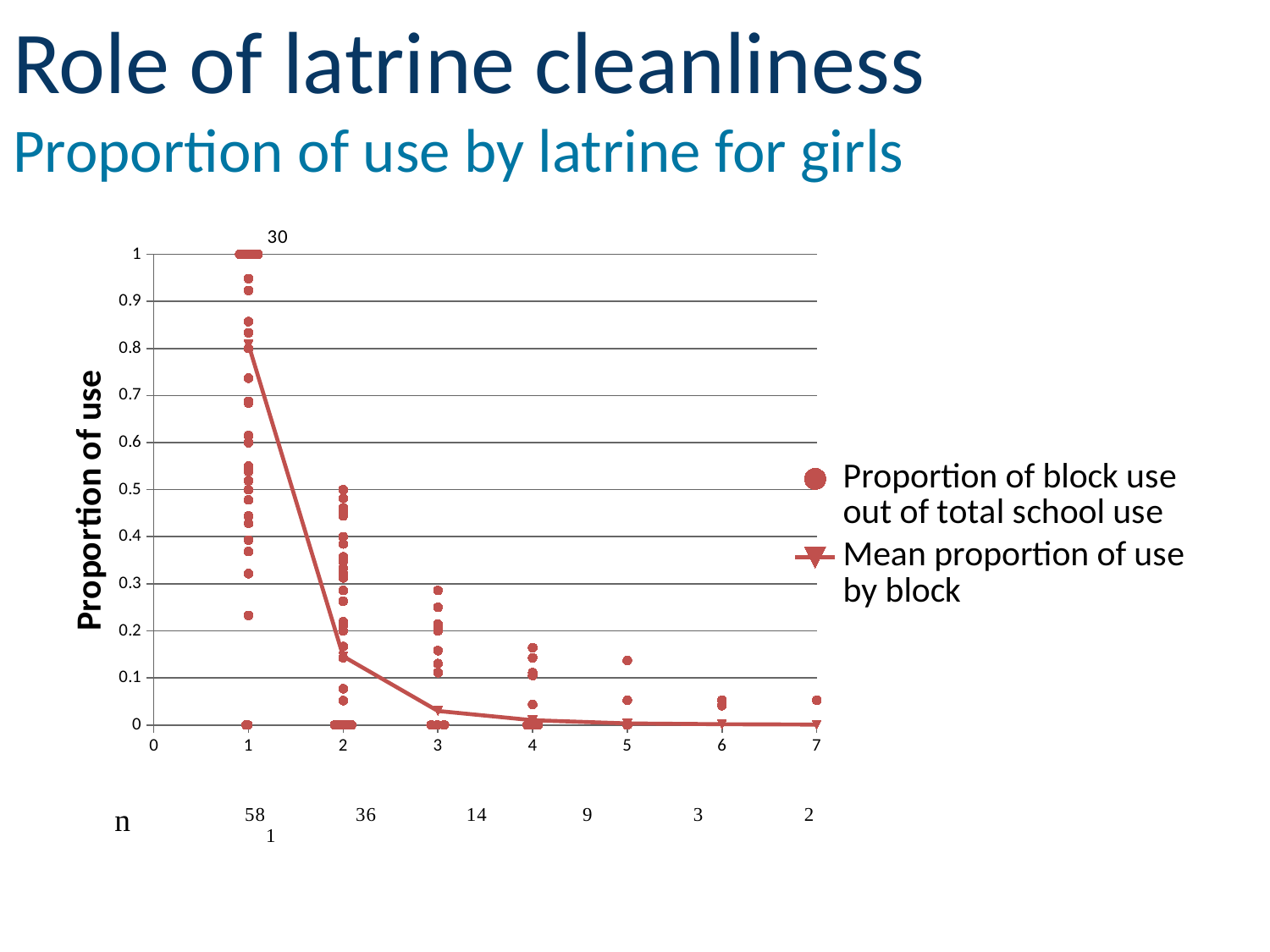
What is the label on the y axis? Proportion of use What is the n value shown below the chart for x = 2? 36 Which is larger, the mean proportion of use by block at x = 1 or at x = 2? x = 1 Is the mean proportion of use by block at x = 2 greater or less than 0.2? less Is the mean proportion of use by block at x = 1 greater or less than 0.7? greater Is the mean proportion of use by block at x = 3 greater or less than 0.1? less How many series does the legend list? 2 At which x value is the mean proportion of use by block highest? 1 What are the two series named in the legend? Proportion of block use out of total school use; Mean proportion of use by block Does the mean proportion of use by block rise or fall as the x value increases from 1 to 7? fall What kind of chart is shown on the slide? scatter chart What data label is printed above the points at x = 1 where the proportion of use equals 1? 30